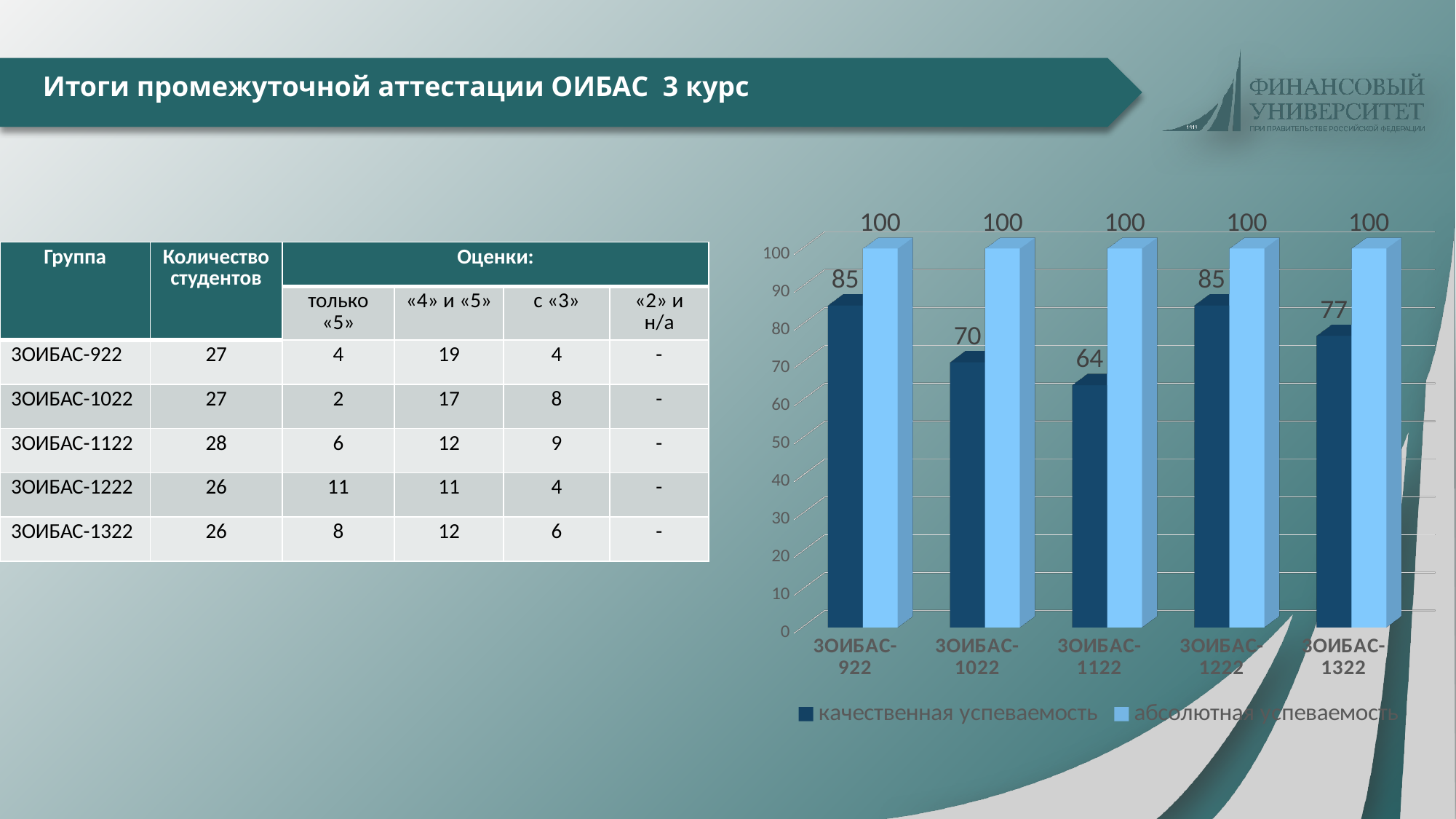
How many groups are shown on the x axis of the chart? 5 What is the value of качественная успеваемость for ЗОИБАС-1122? 64 Which series is shown in light blue in the chart? абсолютная успеваемость What is the difference between качественная успеваемость for ЗОИБАС-922 and ЗОИБАС-1022? 15 Which is larger: качественная успеваемость for ЗОИБАС-1222 or for ЗОИБАС-1322? ЗОИБАС-1222 How many series does the chart legend list? 2 What is the value of абсолютная успеваемость for ЗОИБАС-1022? 100 Which group has the lowest качественная успеваемость? ЗОИБАС-1122 What is the value of качественная успеваемость for ЗОИБАС-1322? 77 Is the value of качественная успеваемость for ЗОИБАС-1022 greater or less than 80? less What kind of chart is shown on the slide? bar chart What is the difference between абсолютная успеваемость and качественная успеваемость for ЗОИБАС-1322? 23